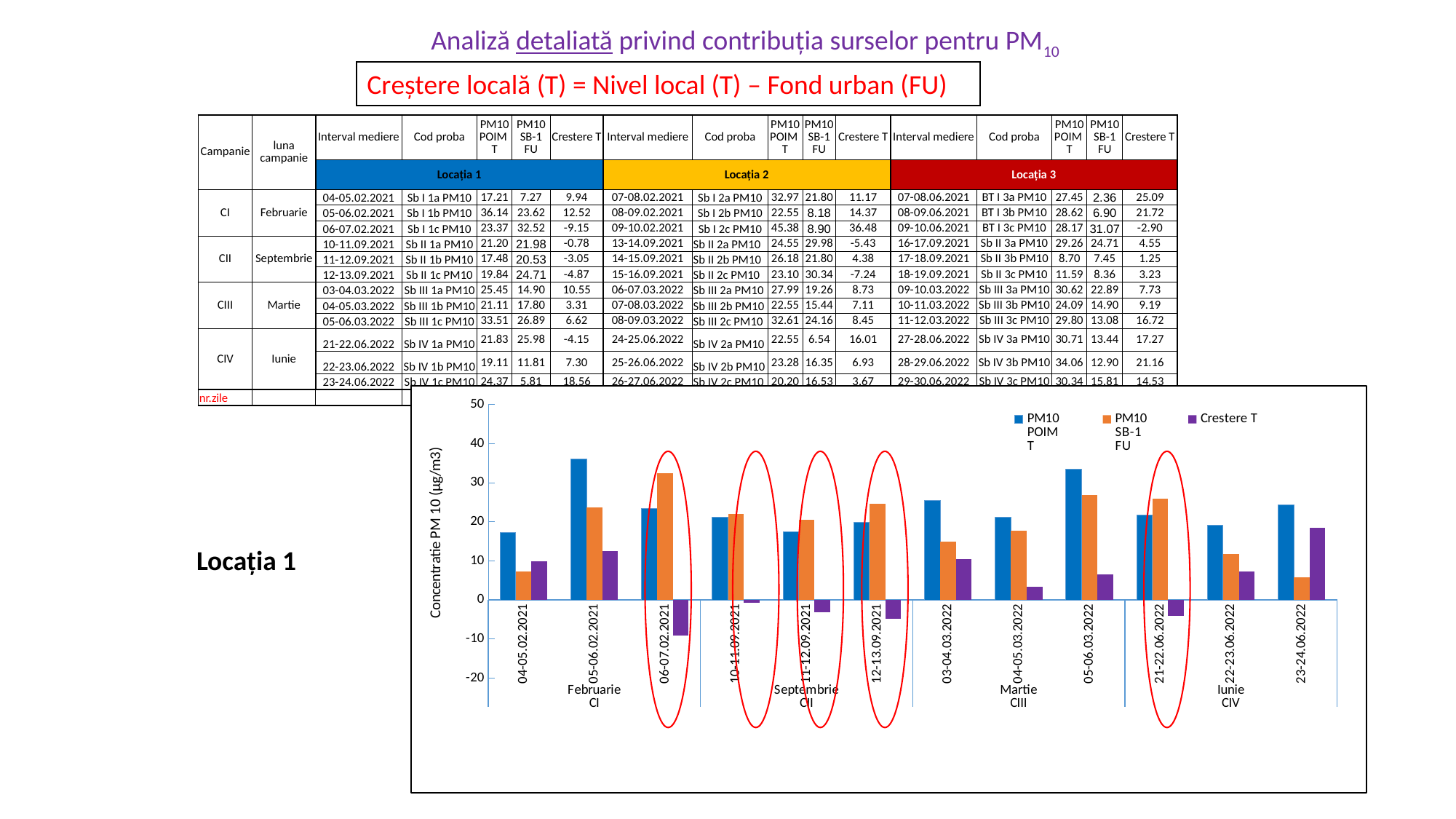
Which date has the lowest Crestere T bar in the chart? 06-07.02.2021 How many series does the chart legend list? 3 What is the title of the chart's vertical axis? Concentratie PM 10 (µg/m3) What type of chart is shown on the slide? bar chart Which date has the highest PM10 SB-1 FU bar in the chart? 06-07.02.2021 Which date has the highest Crestere T bar in the chart? 23-24.06.2022 How many date categories are plotted along the x axis of the chart? 12 For 23-24.06.2022, which is larger: PM10 POIM T or PM10 SB-1 FU? PM10 POIM T Which date has the highest PM10 POIM T bar in the chart? 05-06.02.2021 Is the PM10 POIM T value for 04-05.02.2021 greater or less than 20? less Is the PM10 POIM T value for 05-06.02.2021 greater or less than 30? greater How many dates in the chart have a negative Crestere T bar? 5